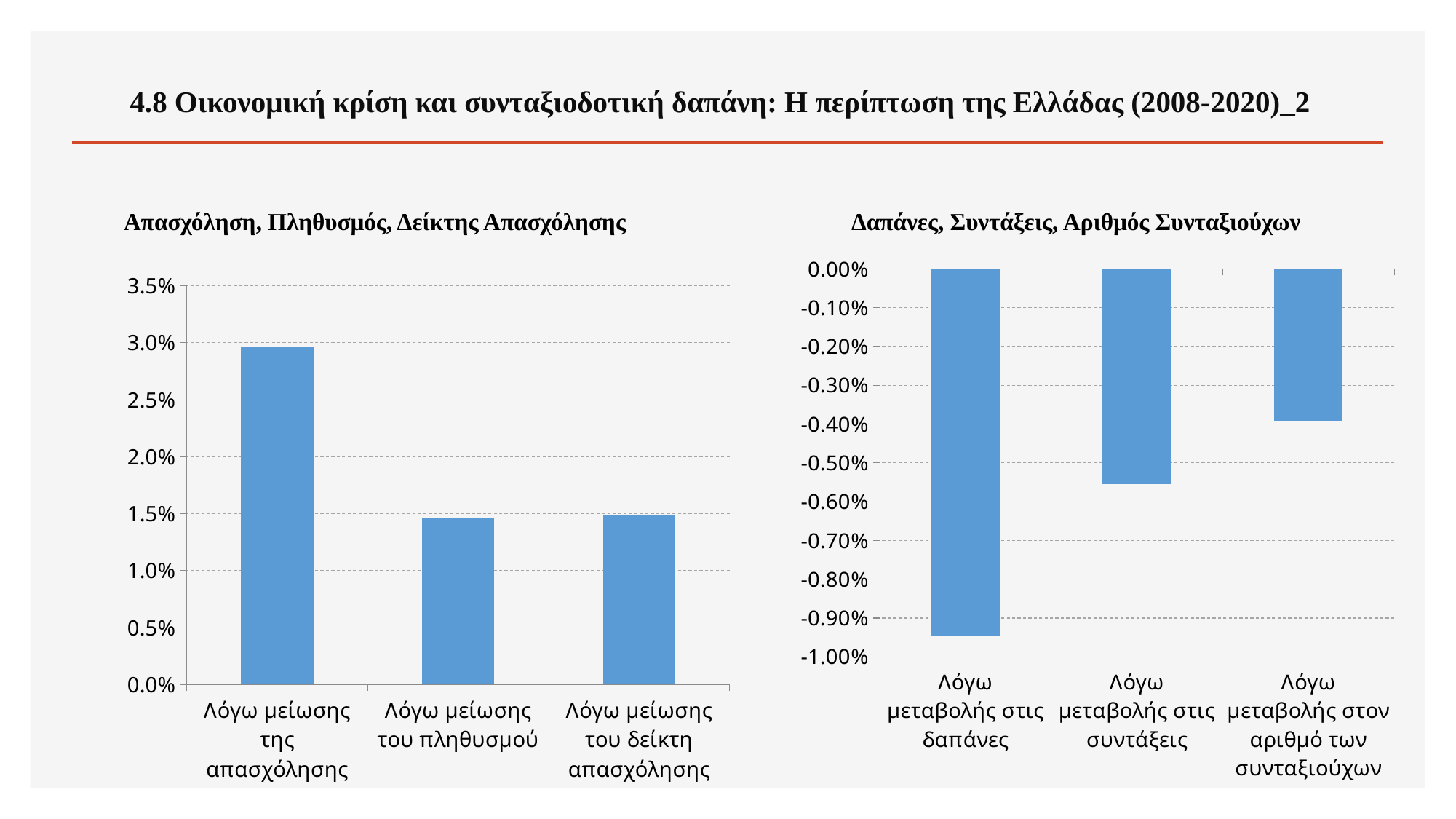
In the left chart titled 'Απασχόληση, Πληθυσμός, Δείκτης Απασχόλησης', is the value for 'Λόγω μείωσης της απασχόλησης' greater or less than 2.5%? greater In the right chart titled 'Δαπάνες, Συντάξεις, Αριθμός Συνταξιούχων', which category has the lowest (most negative) value? Λόγω μεταβολής στις δαπάνες In the right chart titled 'Δαπάνες, Συντάξεις, Αριθμός Συνταξιούχων', is the value for 'Λόγω μεταβολής στις δαπάνες' greater or less than -0.90%? less In the left chart titled 'Απασχόληση, Πληθυσμός, Δείκτης Απασχόλησης', which category has the highest value? Λόγω μείωσης της απασχόλησης In the left chart titled 'Απασχόληση, Πληθυσμός, Δείκτης Απασχόλησης', is the value for 'Λόγω μείωσης του πληθυσμού' greater or less than 1.0%? greater How many categories are shown in the left chart titled 'Απασχόληση, Πληθυσμός, Δείκτης Απασχόλησης'? 3 In the right chart titled 'Δαπάνες, Συντάξεις, Αριθμός Συνταξιούχων', which category has the highest value (closest to zero)? Λόγω μεταβολής στον αριθμό των συνταξιούχων In the left chart titled 'Απασχόληση, Πληθυσμός, Δείκτης Απασχόλησης', which is larger: the value for 'Λόγω μείωσης της απασχόλησης' or the value for 'Λόγω μείωσης του πληθυσμού'? Λόγω μείωσης της απασχόλησης What is the title of the chart on the right side of the slide? Δαπάνες, Συντάξεις, Αριθμός Συνταξιούχων What kind of chart is the right chart titled 'Δαπάνες, Συντάξεις, Αριθμός Συνταξιούχων'? bar chart